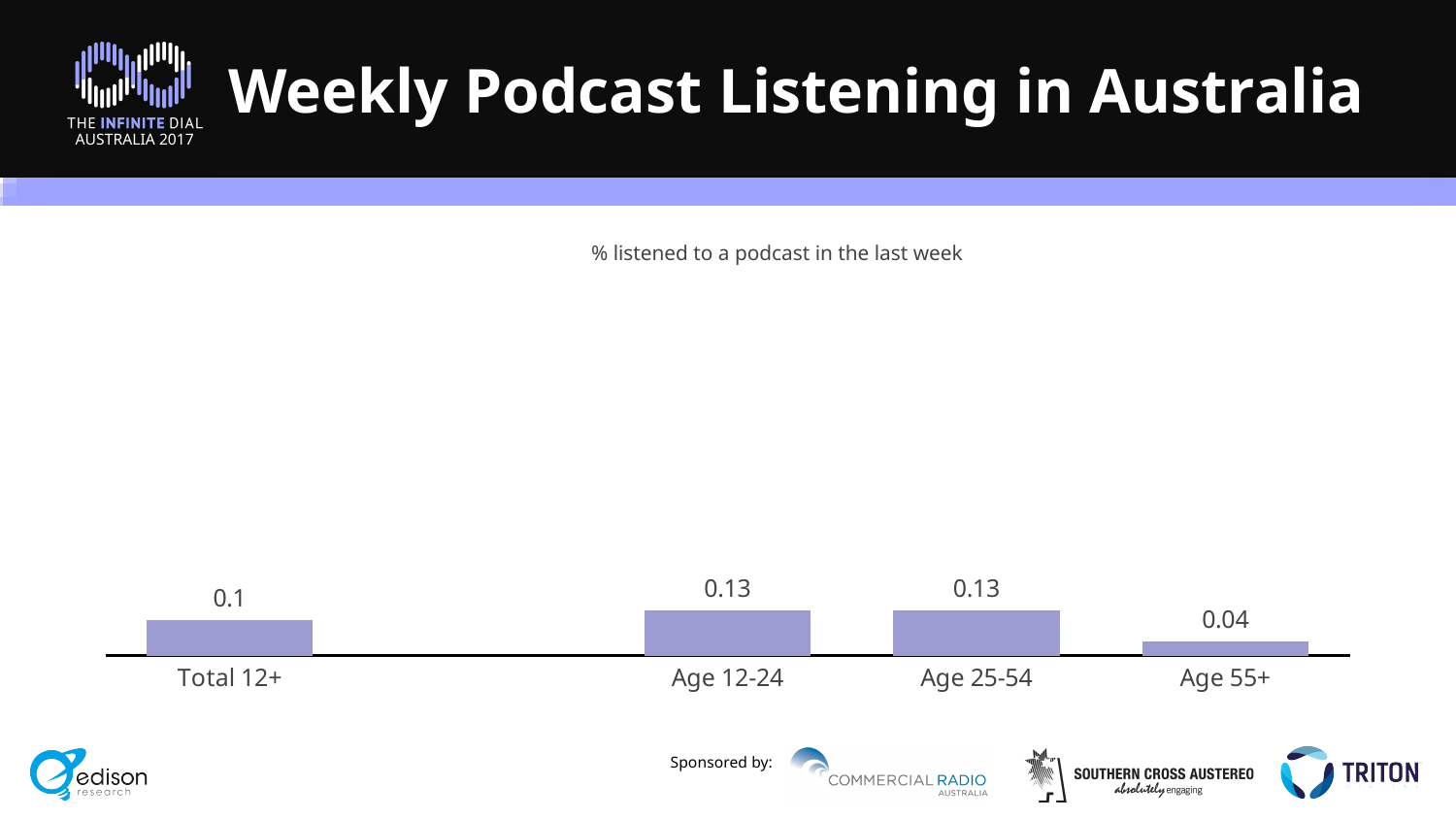
What is the difference between the values for Age 12-24 and Age 55+? 0.09 What is the value for Age 25-54? 0.13 Which is larger, the value for Age 25-54 or the value for Total 12+? Age 25-54 What is the difference between the values for Age 25-54 and Total 12+? 0.03 What is the value for Age 12-24? 0.13 What is the value for Age 55+? 0.04 Which age group has the lowest value? Age 55+ What kind of chart is shown on the slide? Bar chart Which is larger, the value for Total 12+ or the value for Age 55+? Total 12+ What is the title of the slide? Weekly Podcast Listening in Australia What is the value for Total 12+? 0.1 How many categories are shown in the chart? 4